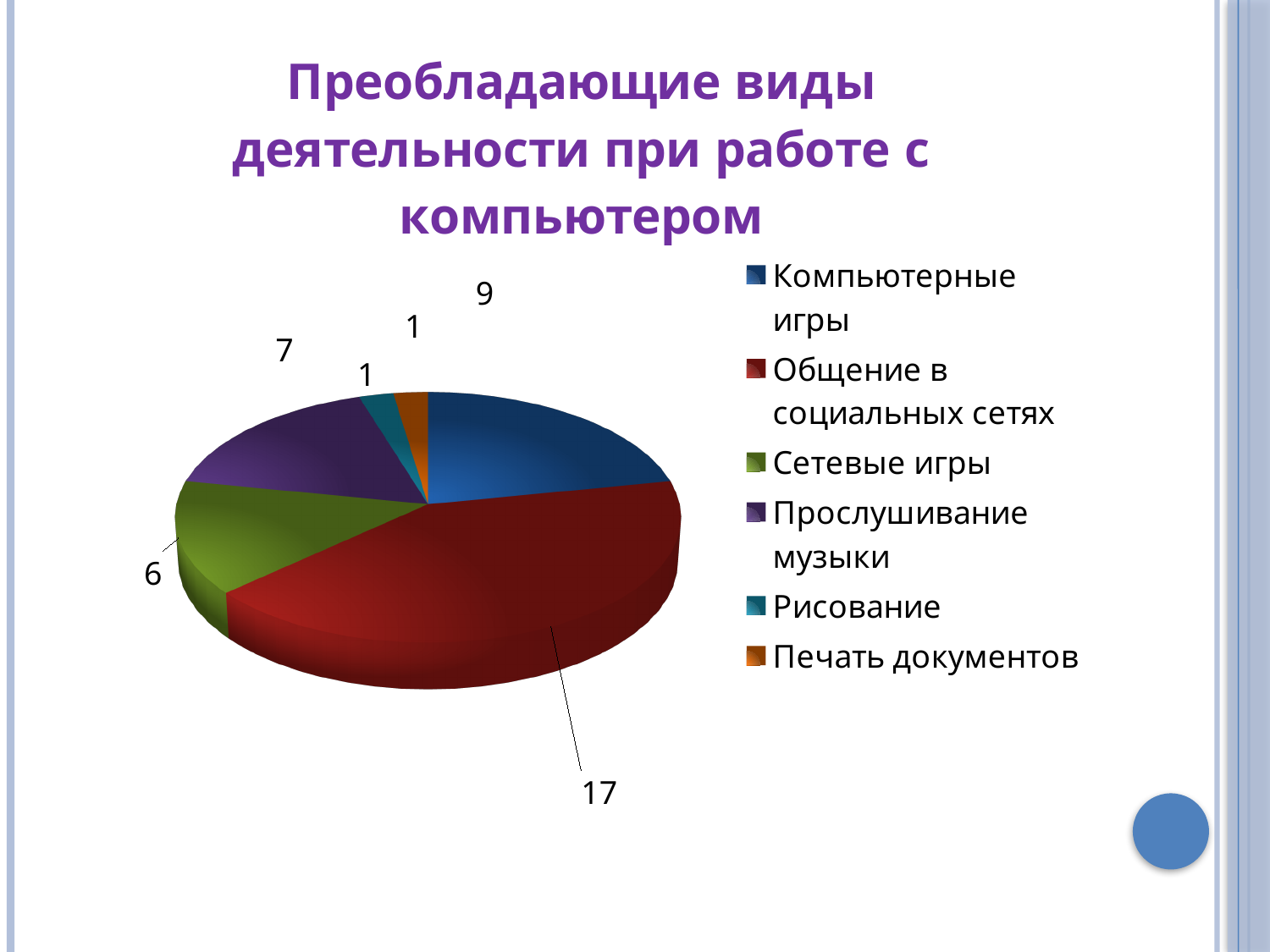
What is the total of all the values shown on the pie chart? 41 Which is larger, the value for Прослушивание музыки or the value for Сетевые игры? Прослушивание музыки What is the difference between the values for Общение в социальных сетях and Компьютерные игры? 8 What kind of chart is shown on the slide? pie chart What colour is the slice for Печать документов? orange What is the value for Сетевые игры? 6 How many categories does the legend list? 6 What is the value for Рисование? 1 What is the value for Прослушивание музыки? 7 What is the value for Компьютерные игры? 9 What is the value for Общение в социальных сетях? 17 Which category has the largest slice of the pie? Общение в социальных сетях